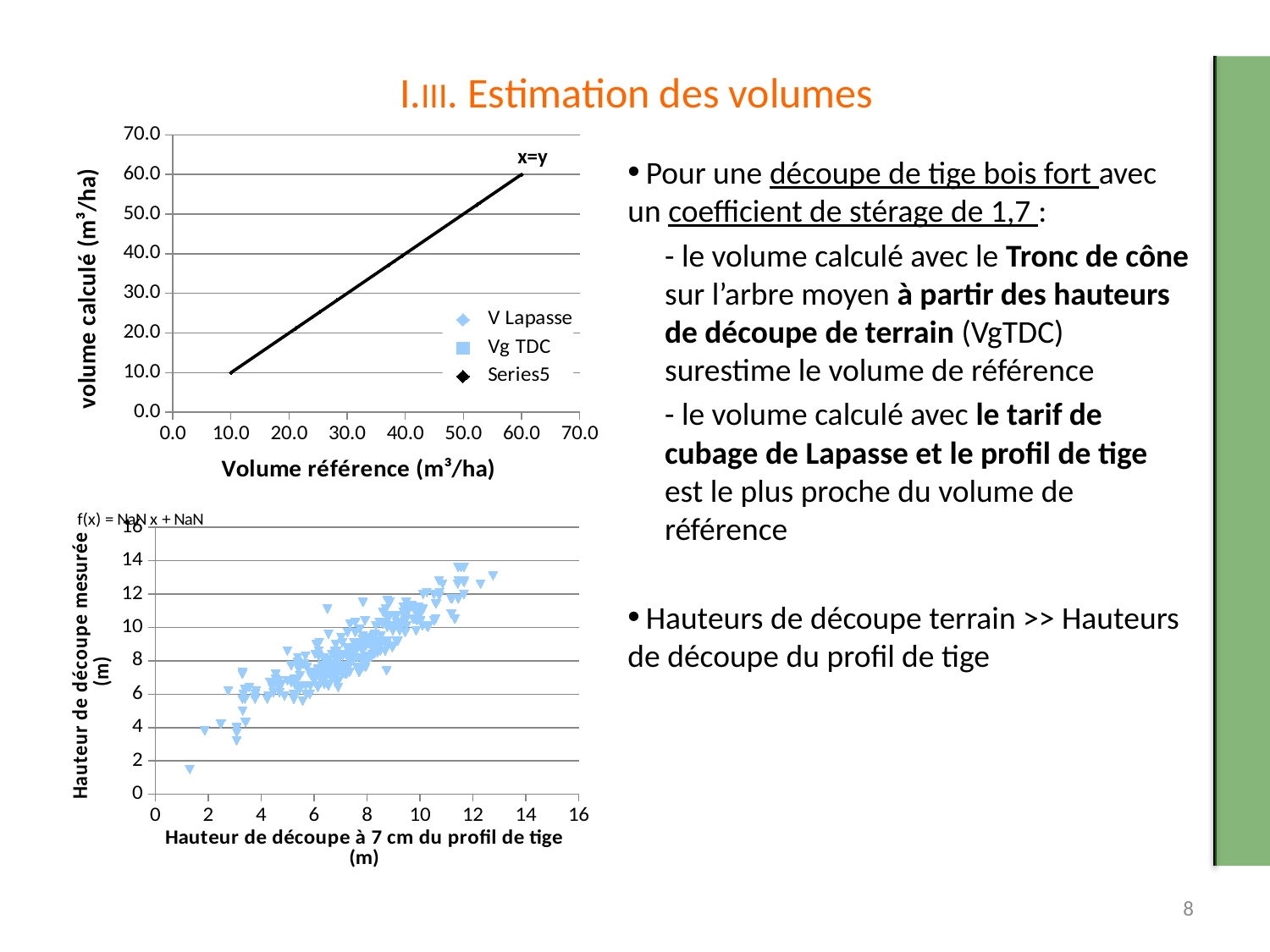
In the top chart, at what x value does the x=y line end? 60.0 In the bottom chart, is the highest measured cut height greater or less than 12? greater How many series does the legend of the top chart list? 3 In the top chart, what label is written next to the diagonal line? x=y In the bottom chart, is the measured cut height of the point with the lowest profile cut height greater or less than 4? less In the top chart, at what x value does the x=y line start? 10.0 What is the x-axis title of the bottom chart? Hauteur de découpe à 7 cm du profil de tige (m) What is the maximum value shown on the y axis of the top chart? 70.0 In the bottom chart, do the measured cut heights rise or fall as the profile cut height increases along the x axis? rise What kind of chart is the top chart on the slide? scatter chart What is the maximum value shown on the x axis of the bottom chart? 16 What kind of chart is the bottom chart on the slide? scatter chart